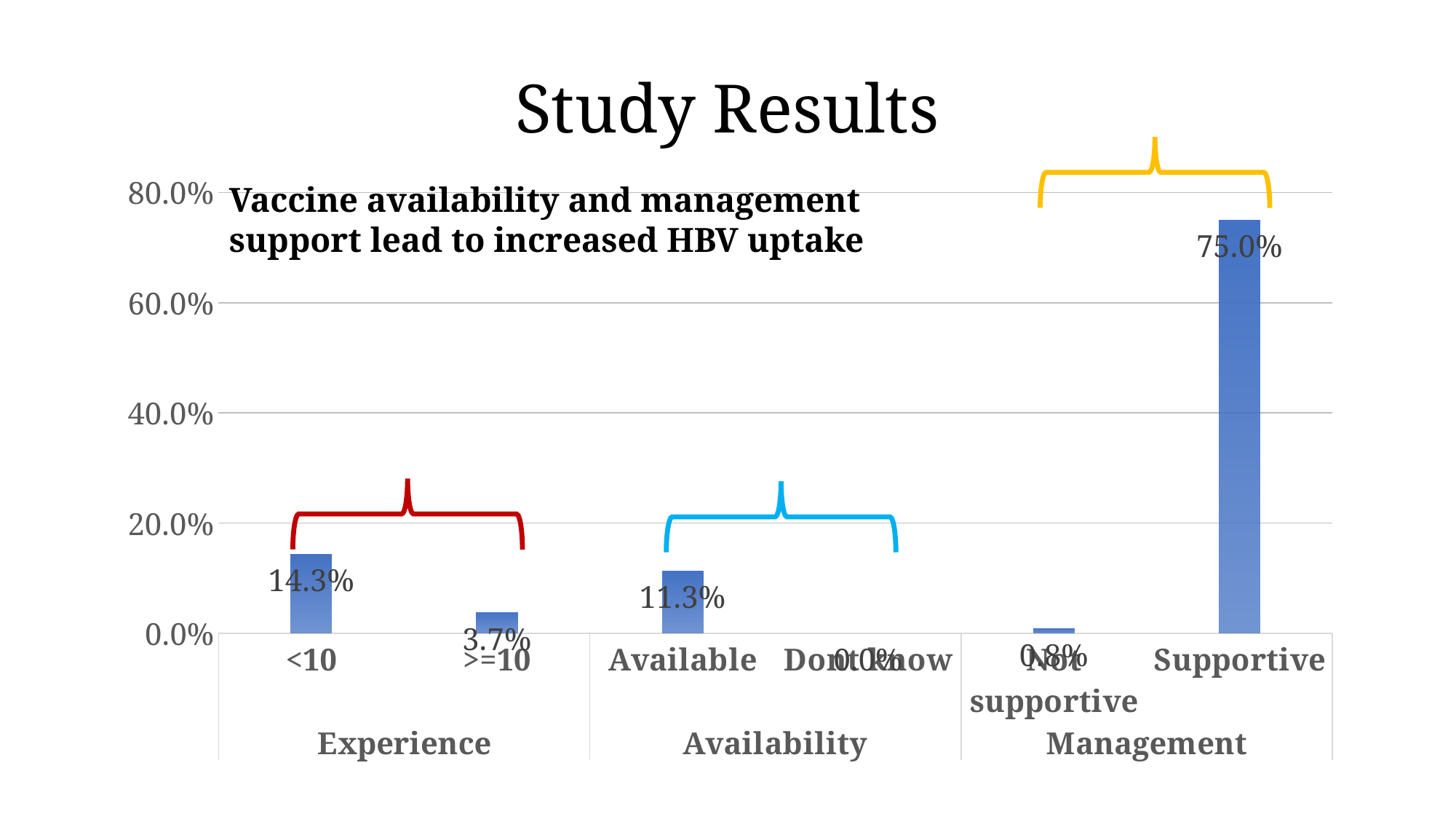
What is the title text shown on the chart? Vaccine availability and management support lead to increased HBV uptake What kind of chart is shown on the slide? bar chart What is the value for the >=10 category under Experience? 3.7% Which is larger, the value for <10 or the value for Available? <10 What is the value for the <10 category under Experience? 14.3% How many bars are plotted in the chart? 6 Is the value for Supportive greater or less than 60.0%? greater What is the difference between the Supportive and Not supportive values under Management? 74.2% What is the difference between the <10 and >=10 values under Experience? 10.6% Which category has the highest value in the chart? Supportive What is the value for the Supportive category under Management? 75.0% What is the value for the Available category under Availability? 11.3%